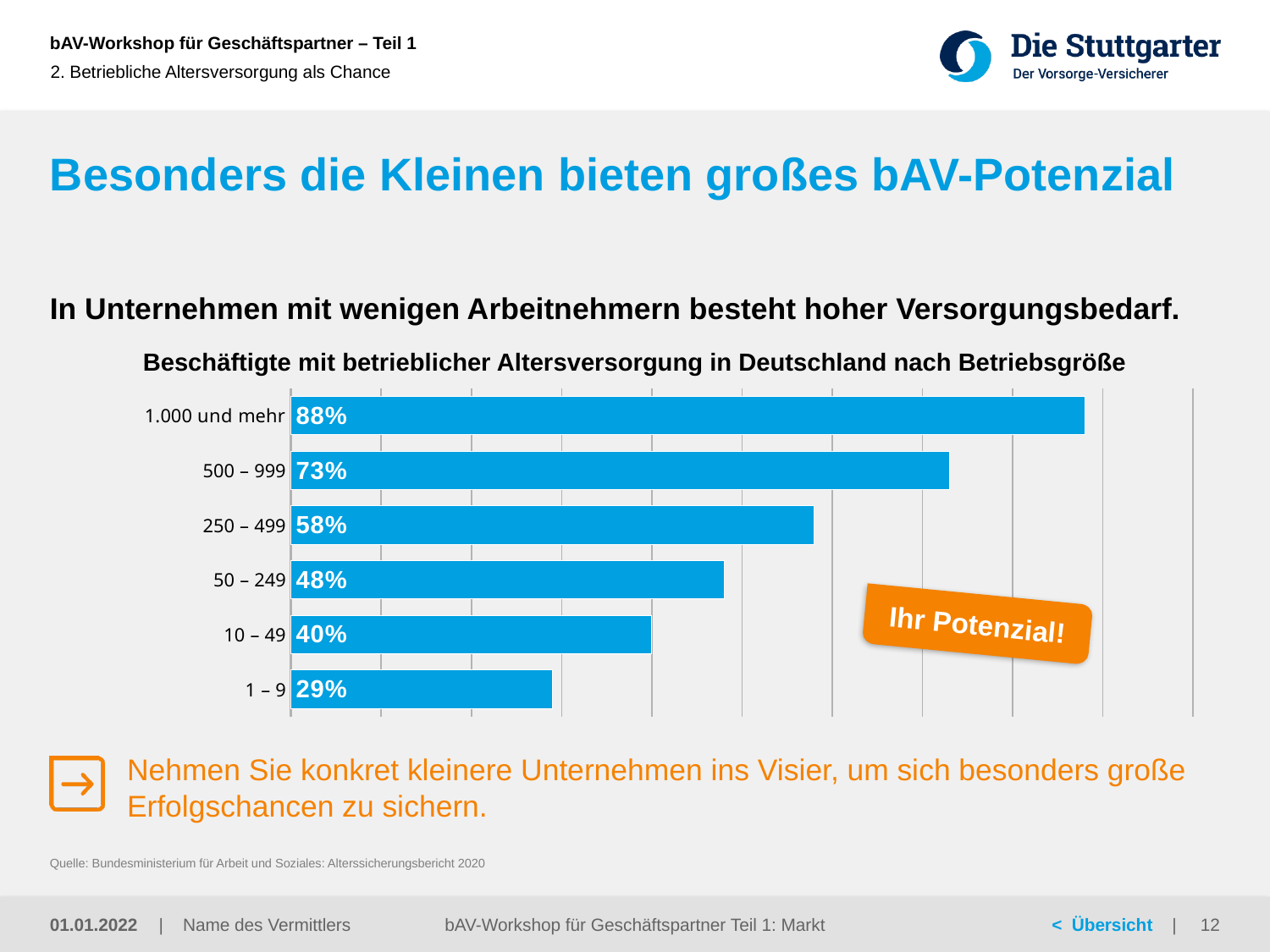
What is the difference in percentage points between the 1.000 und mehr category and the 1 – 9 category? 59 What percentage of employees have occupational pension coverage in companies with 1.000 und mehr employees? 88% What is the title of the chart? Beschäftigte mit betrieblicher Altersversorgung in Deutschland nach Betriebsgröße What is the value shown for the 1 – 9 company size category? 29% Which company size category has the lowest share of employees with occupational pension coverage? 1 – 9 What is the value shown for the 50 – 249 company size category? 48% How many company size categories are shown in the chart? 6 Which has a higher value: the 10 – 49 category or the 50 – 249 category? 50 – 249 Do the values increase or decrease going from the top bar (1.000 und mehr) to the bottom bar (1 – 9)? Decrease What type of chart is shown on the slide? Bar chart Which company size category has the highest share of employees with occupational pension coverage? 1.000 und mehr What is the difference in percentage points between the 500 – 999 category and the 250 – 499 category? 15